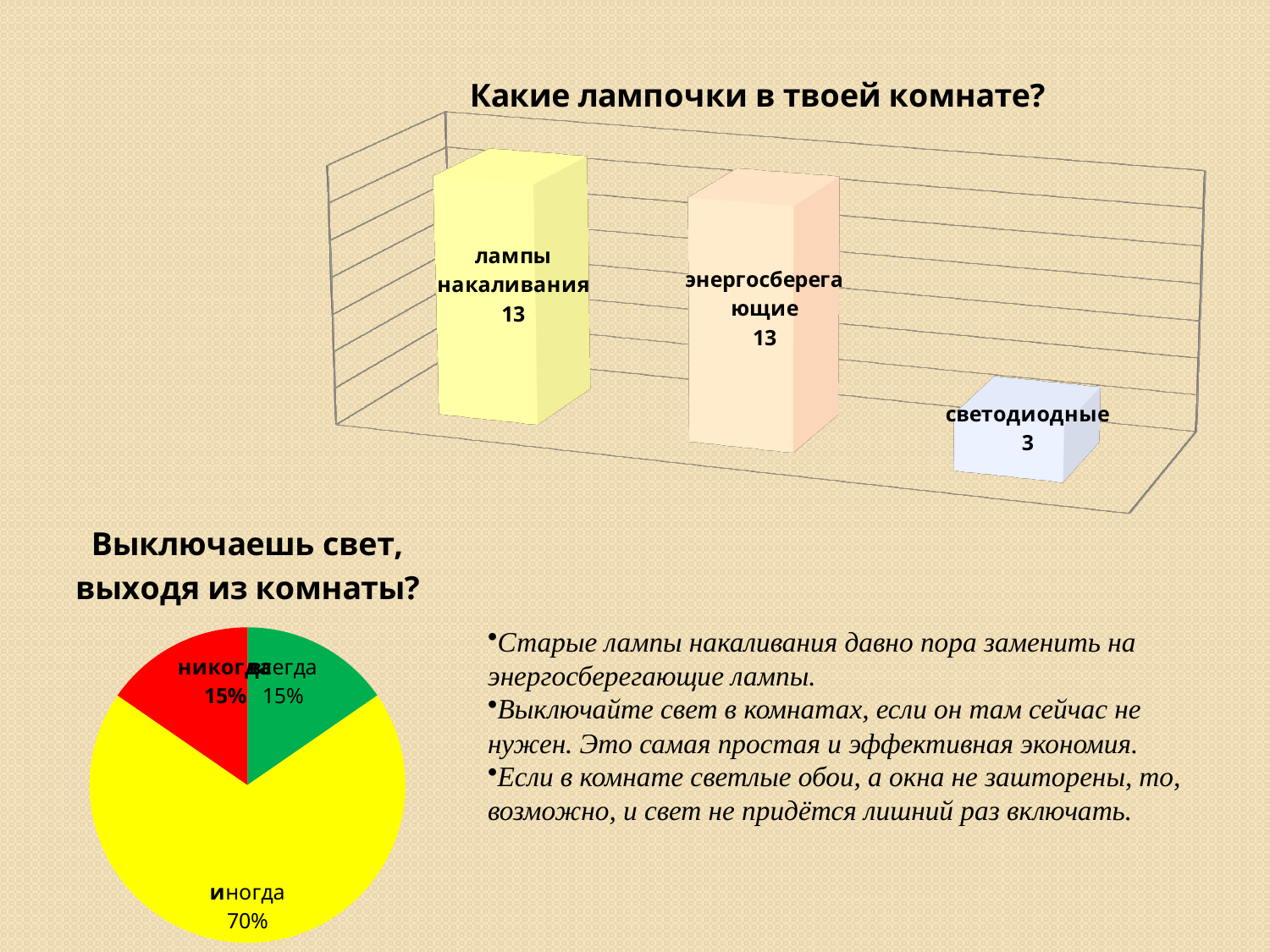
How many categories are shown in the chart 'Какие лампочки в твоей комнате?'? 3 In the pie chart 'Выключаешь свет, выходя из комнаты?', what share does иногда have? 70% What kind of chart is 'Выключаешь свет, выходя из комнаты?'? pie chart In the pie chart 'Выключаешь свет, выходя из комнаты?', what share does никогда have? 15% What kind of chart is 'Какие лампочки в твоей комнате?'? bar chart In the chart 'Какие лампочки в твоей комнате?', which category has the lowest value? светодиодные In the chart 'Какие лампочки в твоей комнате?', what is the difference between the values for лампы накаливания and светодиодные? 10 In the chart 'Какие лампочки в твоей комнате?', which is larger: энергосберегающие or светодиодные? энергосберегающие In the chart 'Какие лампочки в твоей комнате?', what is the value for светодиодные? 3 In the pie chart 'Выключаешь свет, выходя из комнаты?', which slice is the largest? иногда In the chart 'Какие лампочки в твоей комнате?', what is the value for энергосберегающие? 13 In the chart 'Какие лампочки в твоей комнате?', what is the value for лампы накаливания? 13